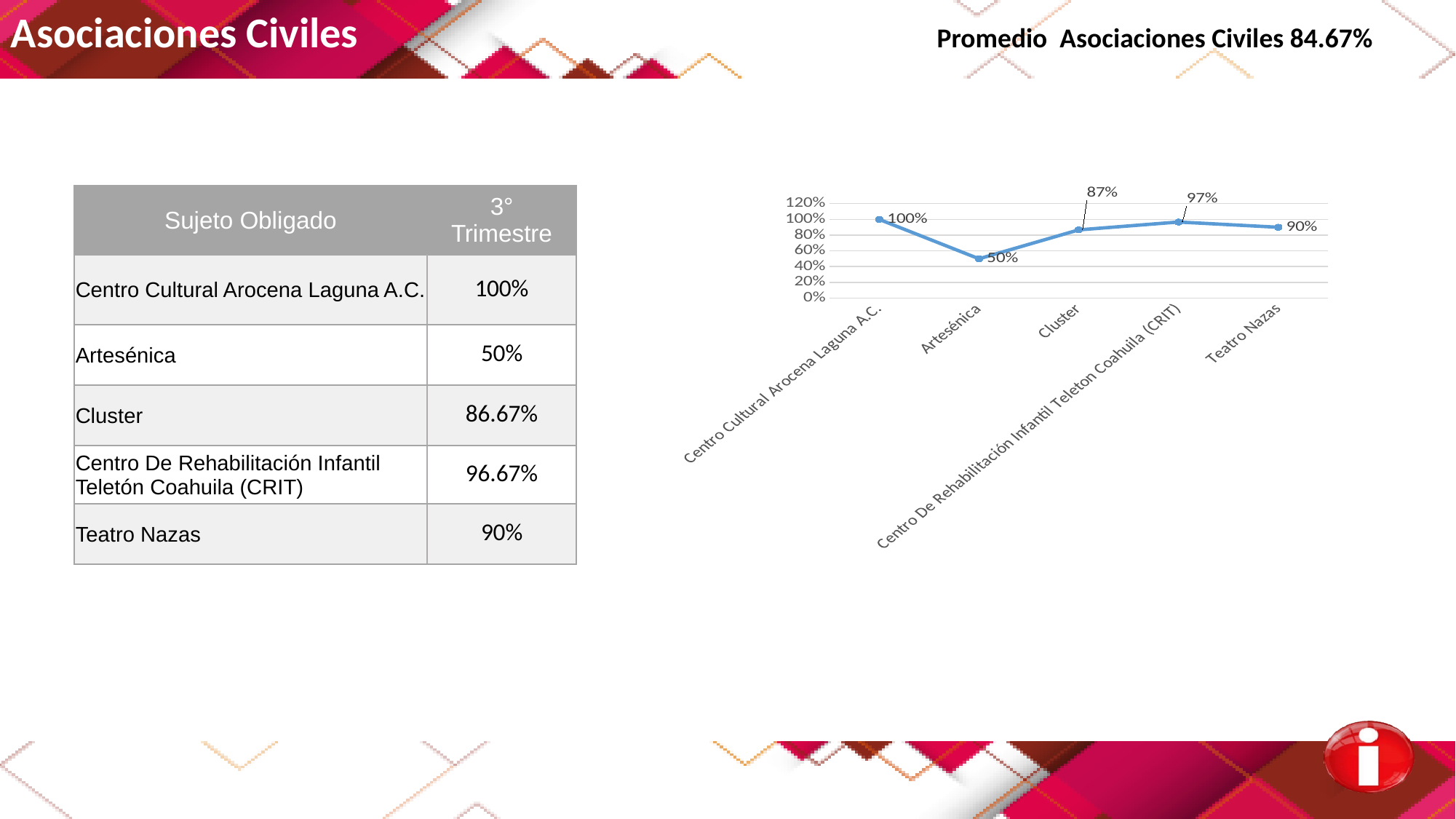
What value does the chart show for Cluster? 87% What value does the chart show for Centro Cultural Arocena Laguna A.C.? 100% What value does the chart show for Teatro Nazas? 90% What is the highest value shown on the chart's vertical axis? 120% How many data points are plotted on the line chart? 5 Which category has the lowest value on the chart? Artesénica Is the value for Artesénica greater or less than 60%? less Which is larger on the chart, the value for Cluster or the value for Teatro Nazas? Teatro Nazas What is the difference between the chart values for Centro Cultural Arocena Laguna A.C. and Artesénica? 50% What type of chart is shown on the slide? line chart Which category has the highest value on the chart? Centro Cultural Arocena Laguna A.C. What value does the chart show for Artesénica? 50%